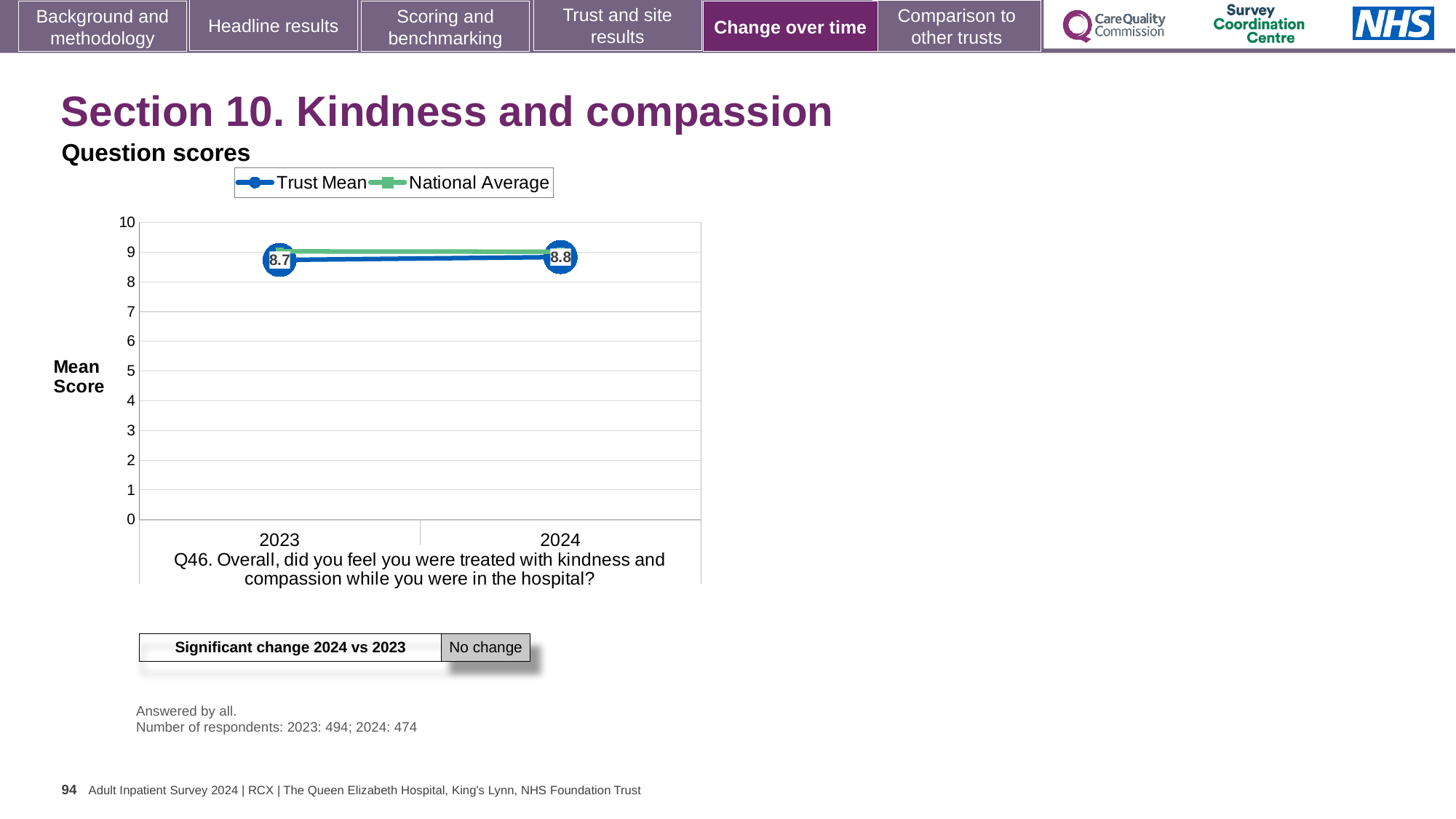
What is the Trust Mean value for 2023? 8.7 What is the label on the y axis of the chart? Mean Score Which year has the higher Trust Mean value, 2023 or 2024? 2024 What is the difference between the Trust Mean values for 2024 and 2023? 0.1 Is the Trust Mean value for 2023 greater or less than 5? greater How many series does the legend list? 2 How many years are shown on the x axis of the chart? 2 What are the two series named in the chart legend? Trust Mean and National Average What is the Trust Mean value for 2024? 8.8 What kind of chart is shown on the slide? line chart Does the Trust Mean rise or fall from 2023 to 2024? rise Is the National Average value for 2024 greater or less than 8? greater